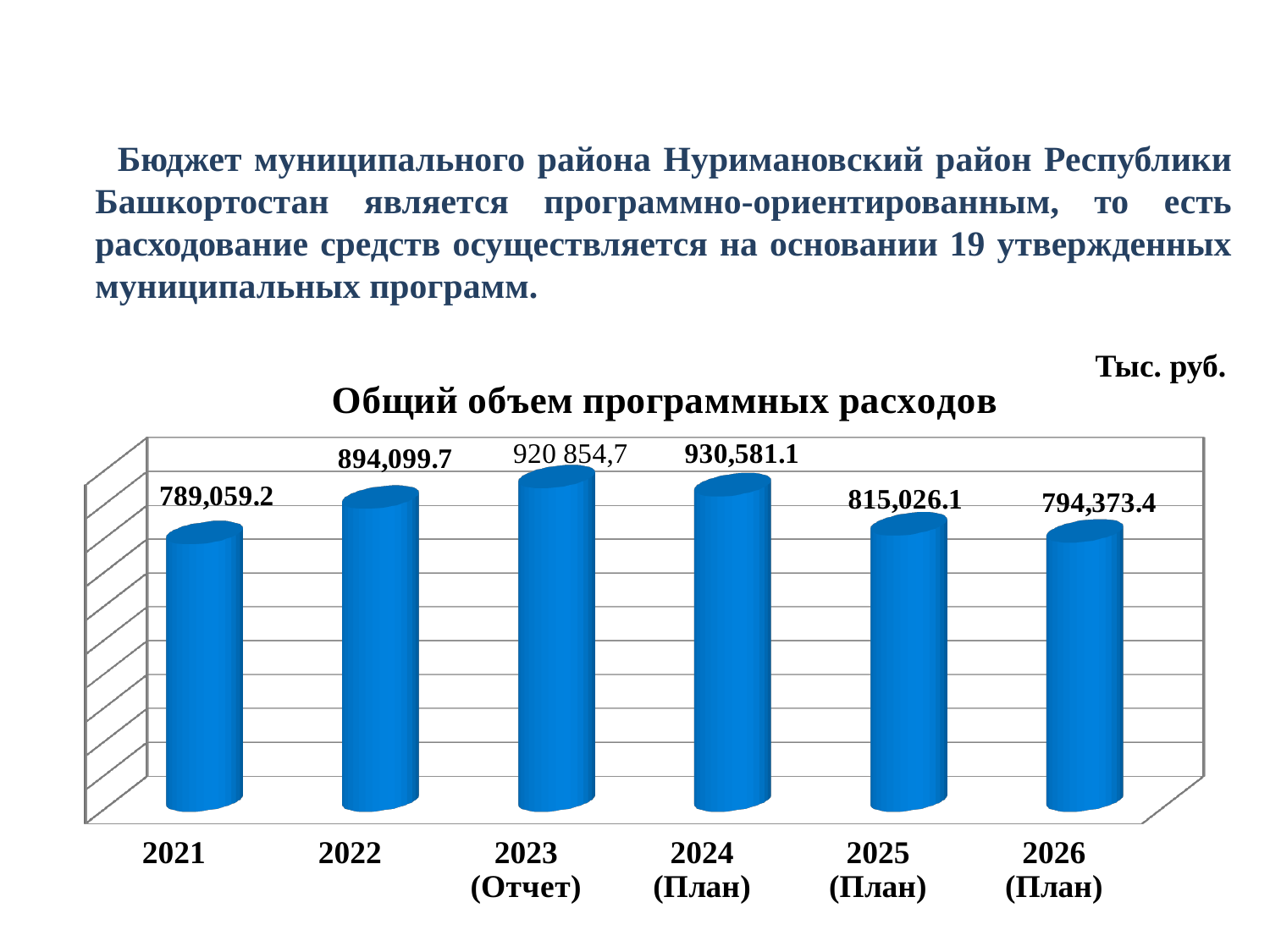
What is the value for 2026 (План) in the chart? 794,373.4 What is the value for 2025 (План) in the chart? 815,026.1 What is the difference between the values for 2025 (План) and 2026 (План)? 20,652.7 What is the difference between the values for 2022 and 2021? 105,040.5 How many years are shown in the chart? 6 In what units are the values in the chart given? Тыс. руб. Which is larger, the value for 2022 or the value for 2025 (План)? 2022 Which year has the lowest value in the chart? 2021 What kind of chart is shown on the slide? Bar chart What is the value for 2023 (Отчет) in the chart? 920 854,7 What is the value for 2021 in the chart "Общий объем программных расходов"? 789,059.2